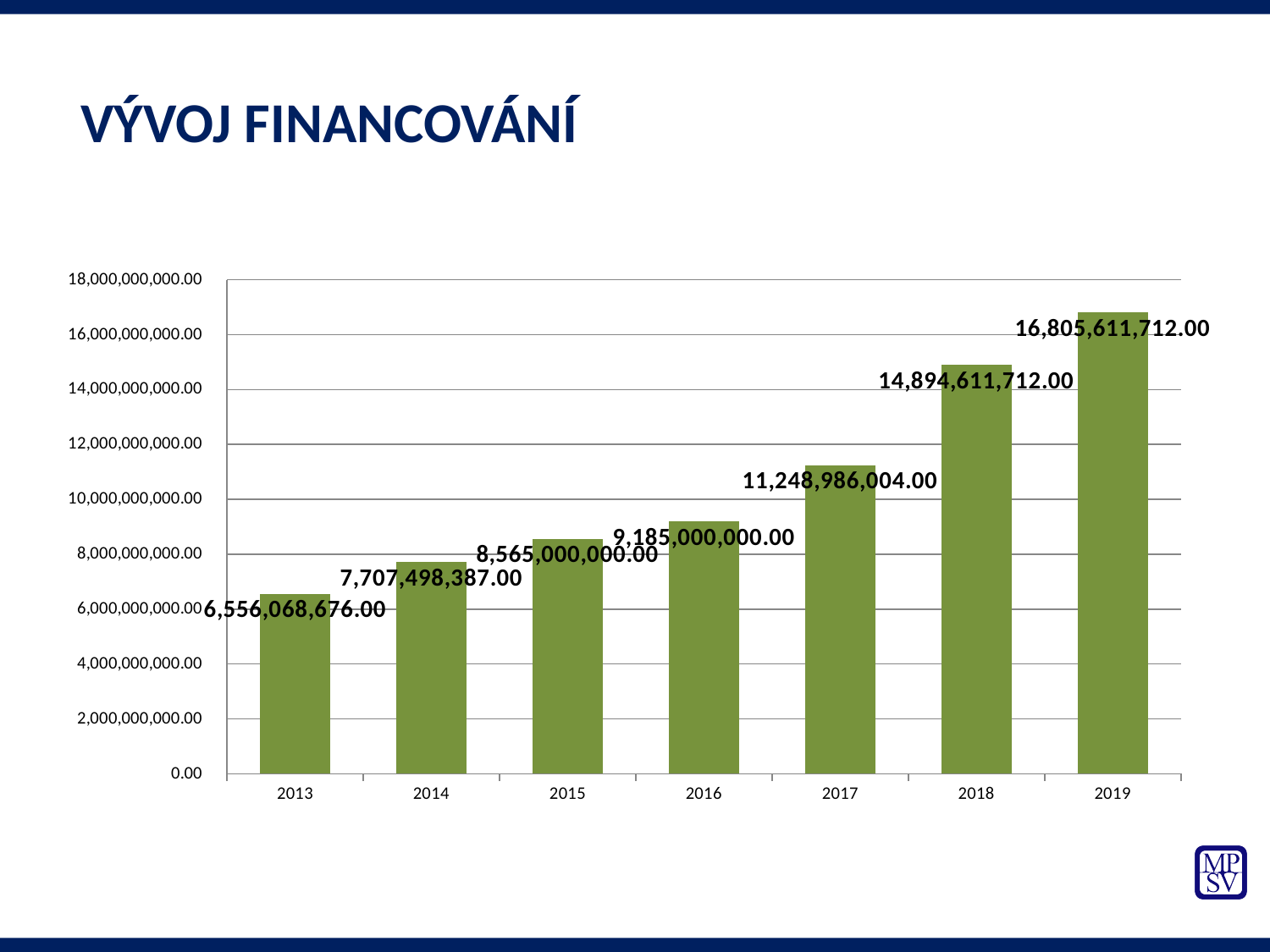
Which is larger, the value for 2015 or the value for 2016? 2016 What kind of chart is shown on the slide? bar chart Which year has the highest value? 2019 What is the value for 2019? 16,805,611,712.00 What is the value for 2013? 6,556,068,676.00 Do the values rise or fall from 2013 to 2019? rise What is the difference between the values for 2019 and 2018? 1,911,000,000.00 How many years are shown on the x axis? 7 Which year has the lowest value? 2013 What is the difference between the values for 2016 and 2015? 620,000,000.00 Is the value for 2017 greater or less than 10,000,000,000.00? greater What is the value for 2017? 11,248,986,004.00